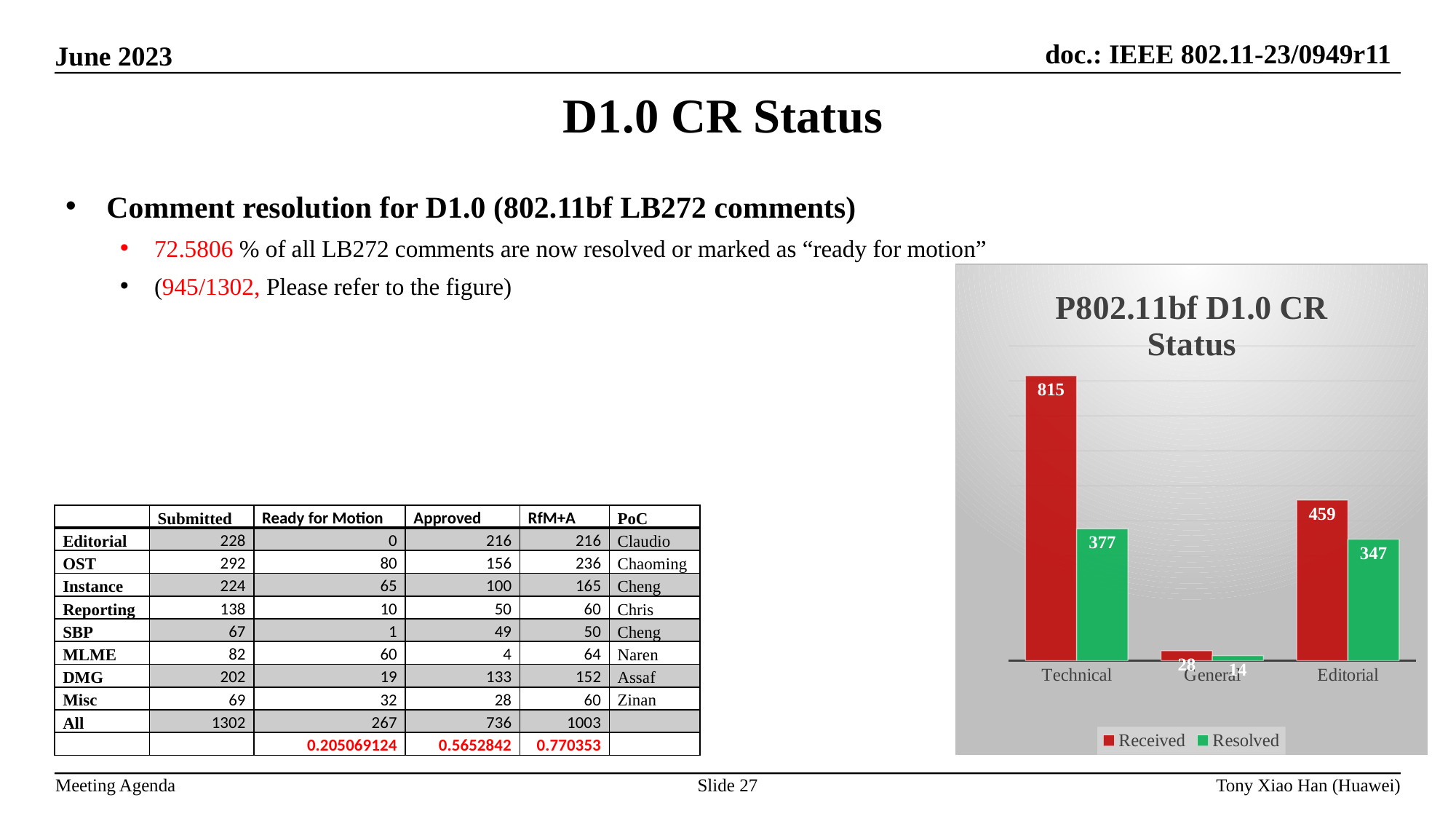
Which series is shown in green in the chart? Resolved What is the difference between Received and Resolved for Technical? 438 Which category has the lowest Resolved value? General What is the Received value for General? 28 What is the title of the chart? P802.11bf D1.0 CR Status Which category has the highest Received value? Technical Is the Received value for Editorial larger than the Resolved value for Technical? Yes How many series does the chart legend list? 2 What type of chart is shown on the slide? bar chart How many categories are shown on the x axis of the chart? 3 What is the Received value for Technical? 815 What is the Resolved value for Editorial? 347